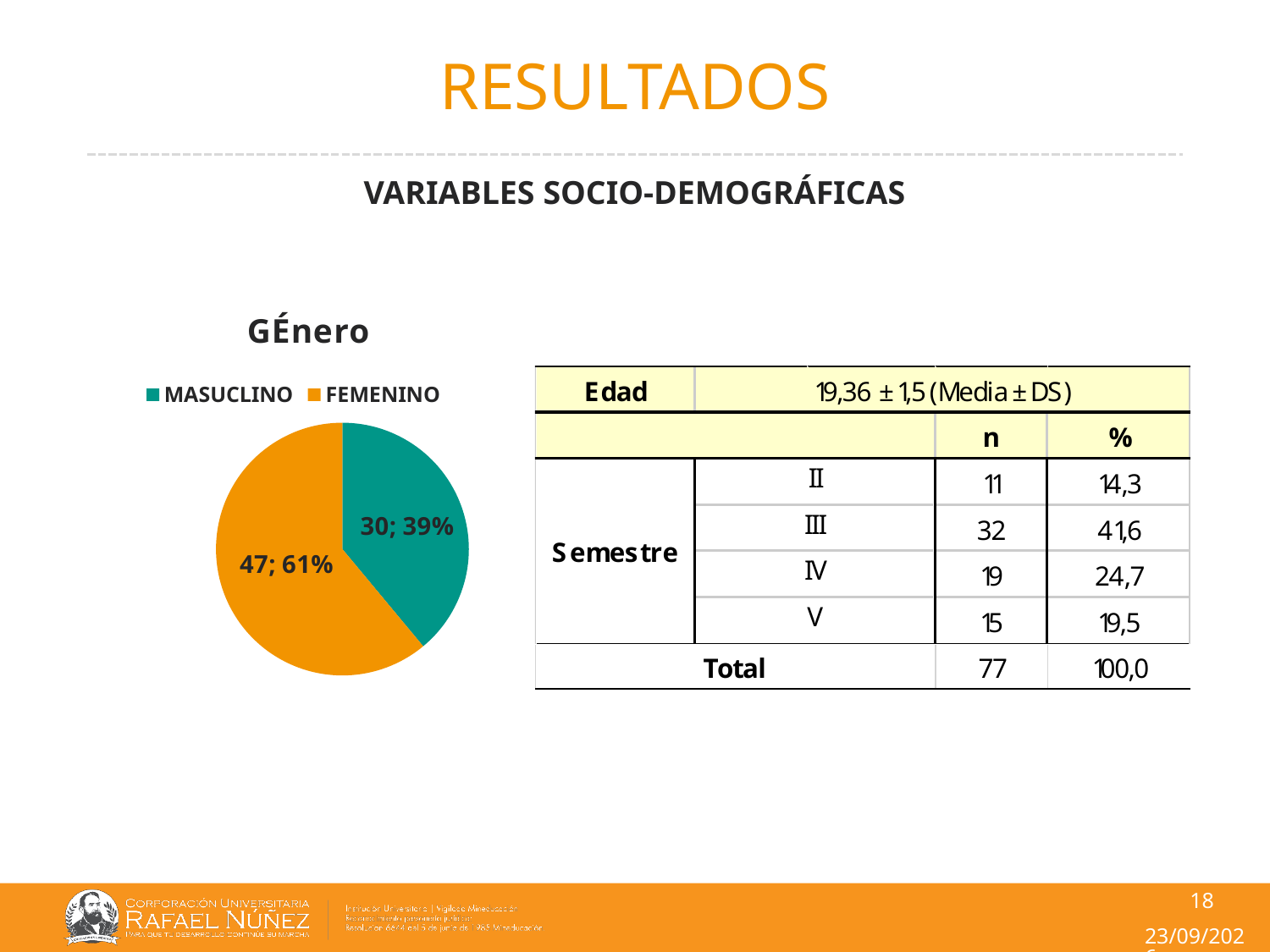
Which colour represents FEMENINO in the pie chart? orange Which category has the smallest slice in the pie chart? MASUCLINO How many entries does the legend of the pie chart list? 2 Which category has the largest slice in the pie chart? FEMENINO What is the count shown for FEMENINO in the pie chart? 47 What kind of chart is shown on the slide? pie chart How many slices does the pie chart have? 2 What is the title of the chart? GÉnero What share of the pie does MASUCLINO represent? 39% What is the difference between the counts for FEMENINO and MASUCLINO? 17 What is the count shown for MASUCLINO in the pie chart? 30 What share of the pie does FEMENINO represent? 61%